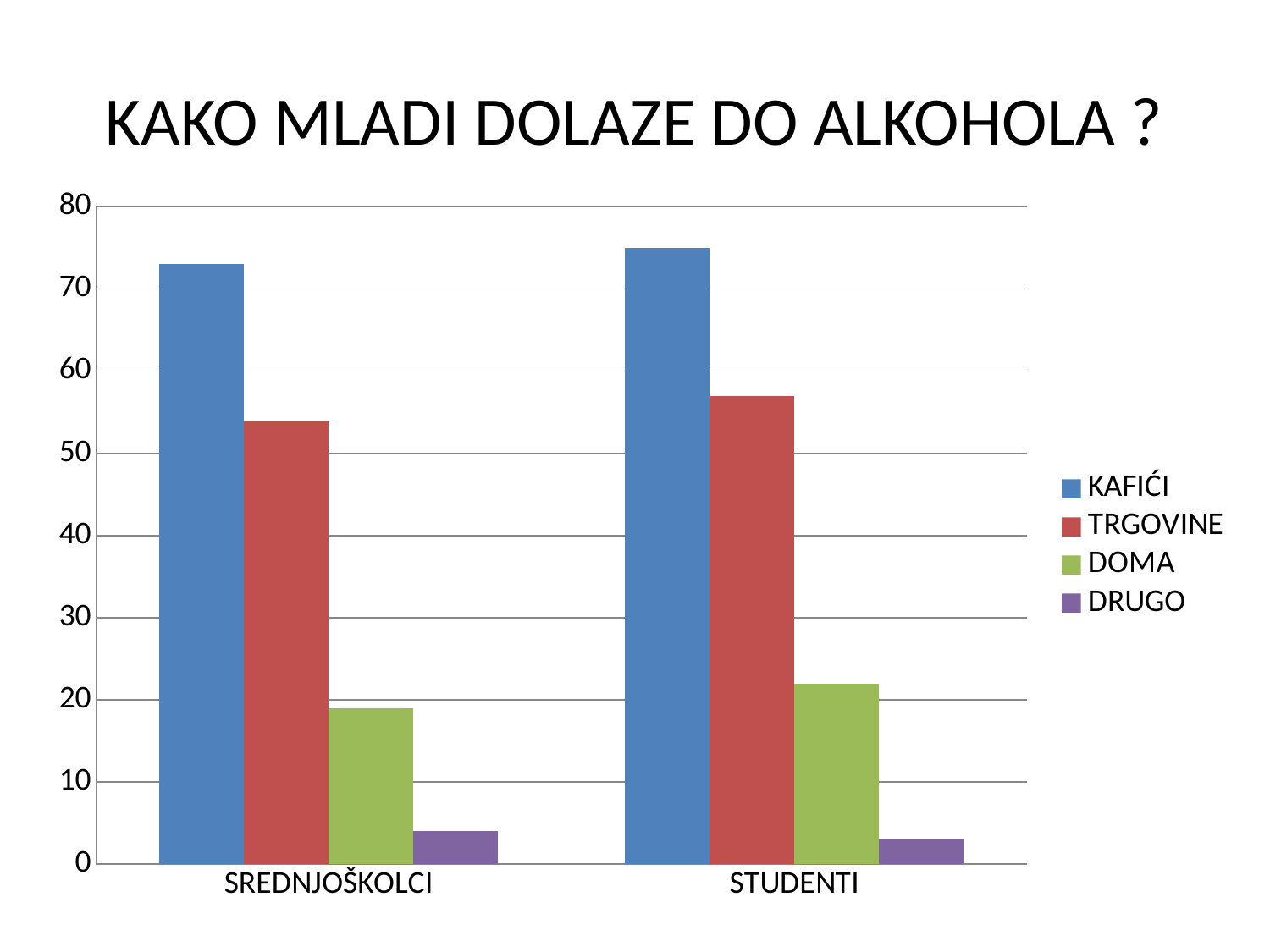
What kind of chart is shown on the slide? bar chart Is the DOMA value for STUDENTI greater or less than 30? less Is the KAFIĆI value for SREDNJOŠKOLCI greater or less than 70? greater Is the DRUGO value for SREDNJOŠKOLCI greater or less than 10? less What is the title of the chart? KAKO MLADI DOLAZE DO ALKOHOLA ? Which series has the lowest value for STUDENTI? DRUGO How many categories are shown on the x axis? 2 Which is larger for STUDENTI: the KAFIĆI value or the TRGOVINE value? KAFIĆI Which category has the larger DOMA value: SREDNJOŠKOLCI or STUDENTI? STUDENTI Which series has the highest value for SREDNJOŠKOLCI? KAFIĆI How many series does the legend list? 4